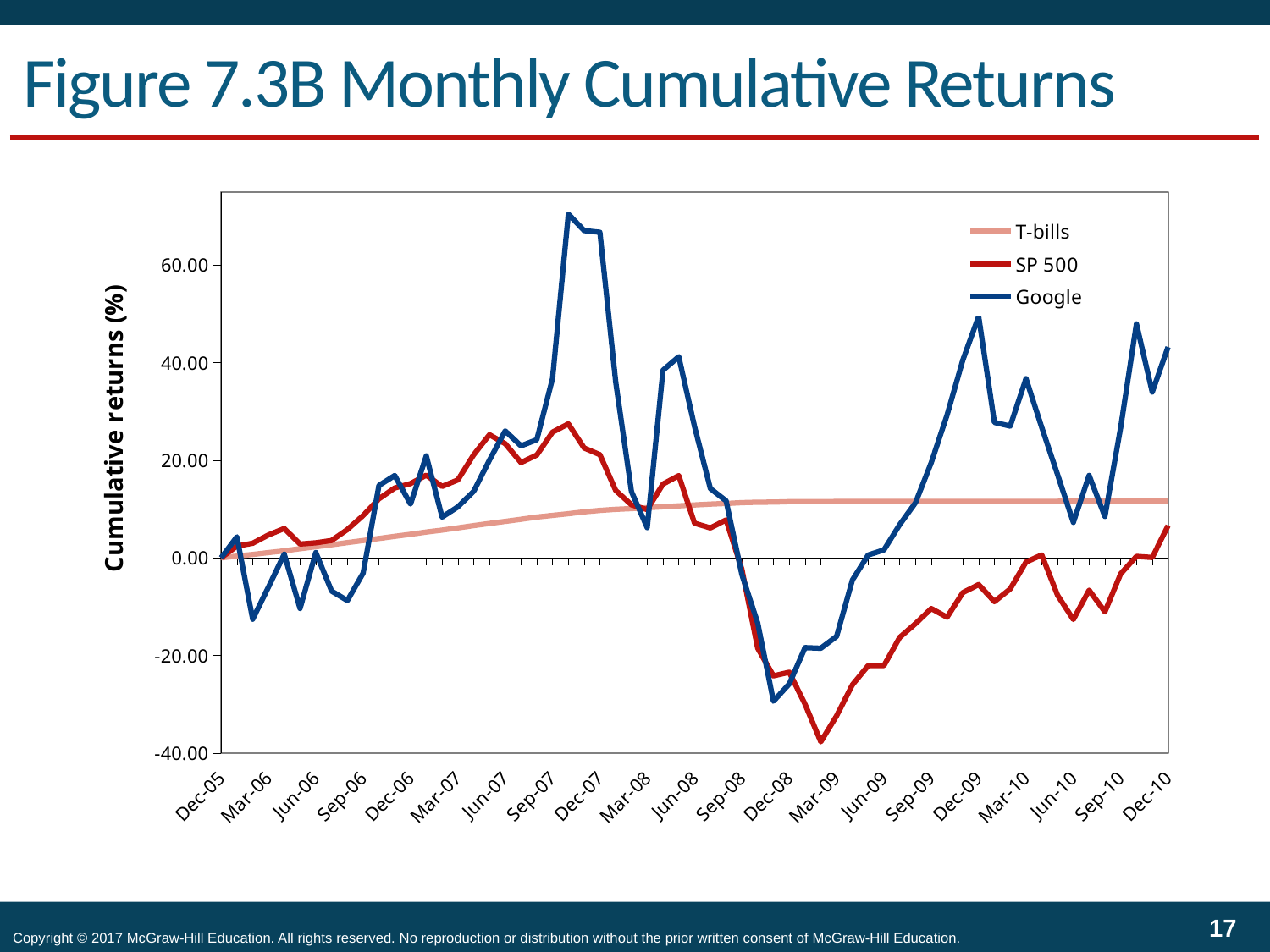
Which series reaches the highest cumulative return at any point on the chart? Google Is the value for SP 500 at Mar-09 greater or less than -20.00? less How many series does the legend list? 3 Which series is drawn in blue? Google Is the value for T-bills at Dec-10 greater or less than 20.00? less Is the value for Google at Dec-09 greater or less than 40.00? greater Which series reaches the lowest cumulative return at any point on the chart? SP 500 How many date labels are shown on the x axis? 21 At Mar-09, which is larger, the value for Google or the value for SP 500? Google What is the label of the vertical axis? Cumulative returns (%) What kind of chart is shown on the slide? Line chart